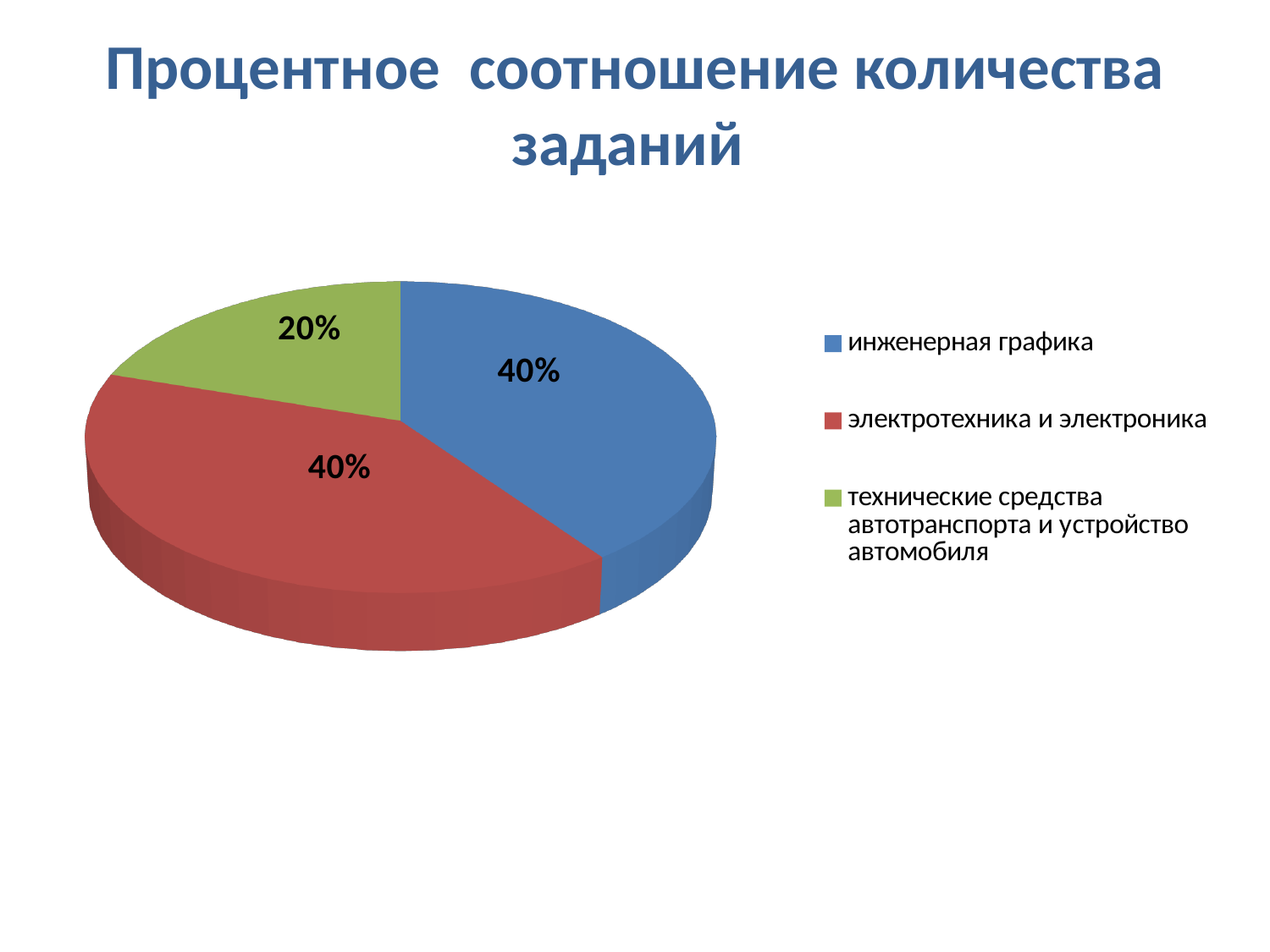
What is the difference between the share of инженерная графика and the share of технические средства автотранспорта и устройство автомобиля? 20% What share of the pie does технические средства автотранспорта и устройство автомобиля have? 20% What kind of chart is shown on the slide? pie chart What colour is the slice for инженерная графика? blue What is the title of the slide? Процентное соотношение количества заданий How many slices does the pie chart have? 3 What share of the pie does инженерная графика have? 40% What share of the pie does электротехника и электроника have? 40% How many entries does the legend list? 3 Which is larger: the share of электротехника и электроника or the share of технические средства автотранспорта и устройство автомобиля? электротехника и электроника Which category has the smallest slice of the pie? технические средства автотранспорта и устройство автомобиля